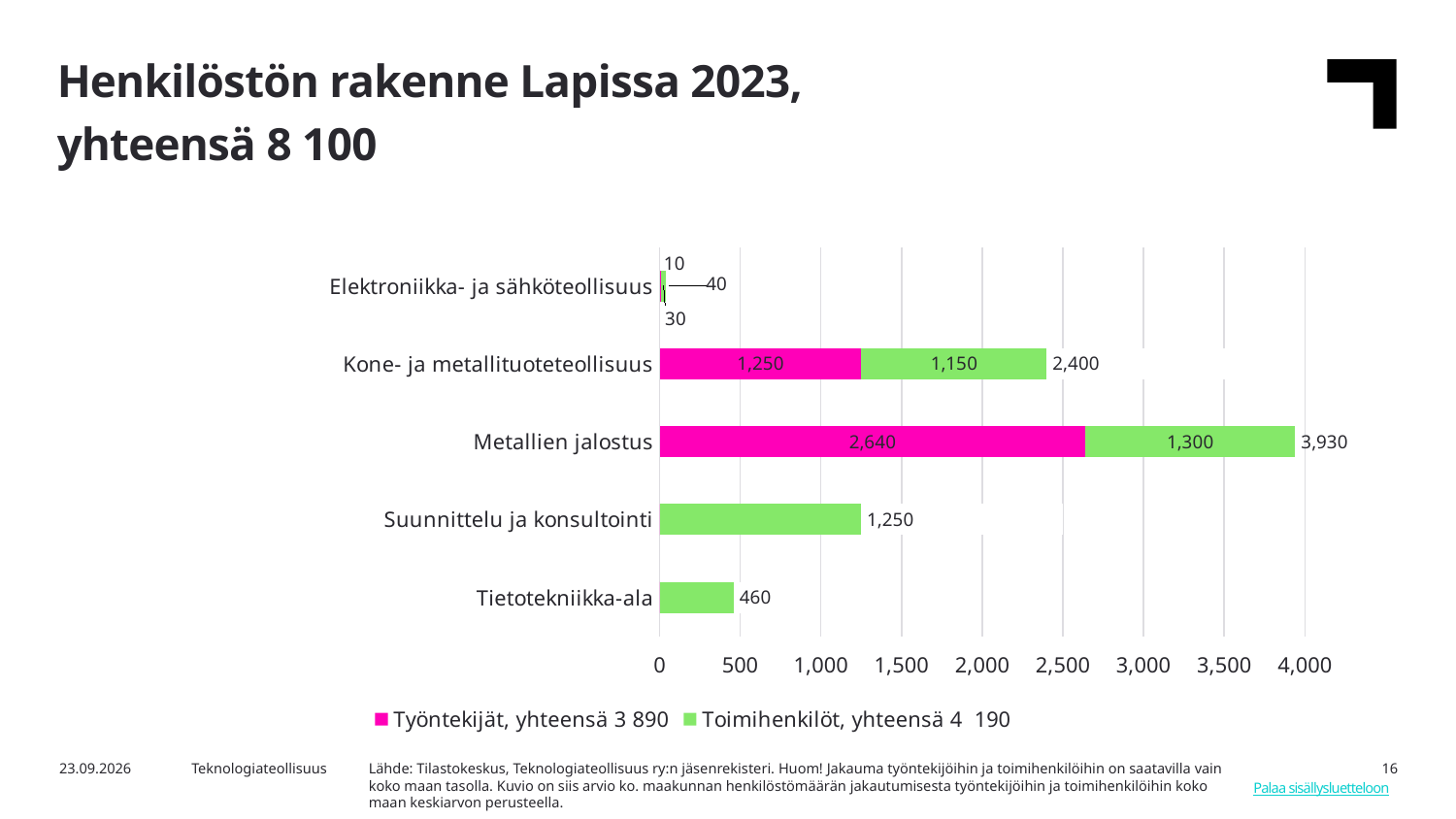
How many series does the legend list? 2 What is the Työntekijät value for Metallien jalostus? 2,640 Which category has the lowest total? Elektroniikka- ja sähköteollisuus Which is larger: the value for Suunnittelu ja konsultointi or the value for Tietotekniikka-ala? Suunnittelu ja konsultointi What is the difference between the Työntekijät values for Metallien jalostus and Kone- ja metallituoteteollisuus? 1,390 What is the total for the Elektroniikka- ja sähköteollisuus bar? 40 How many categories are shown on the chart? 5 What is the total for the Metallien jalostus bar? 3,930 What is the total for the Kone- ja metallituoteteollisuus bar? 2,400 Which category has the highest total? Metallien jalostus What is the Toimihenkilöt value for Kone- ja metallituoteteollisuus? 1,150 What kind of chart is shown on the slide? Stacked bar chart